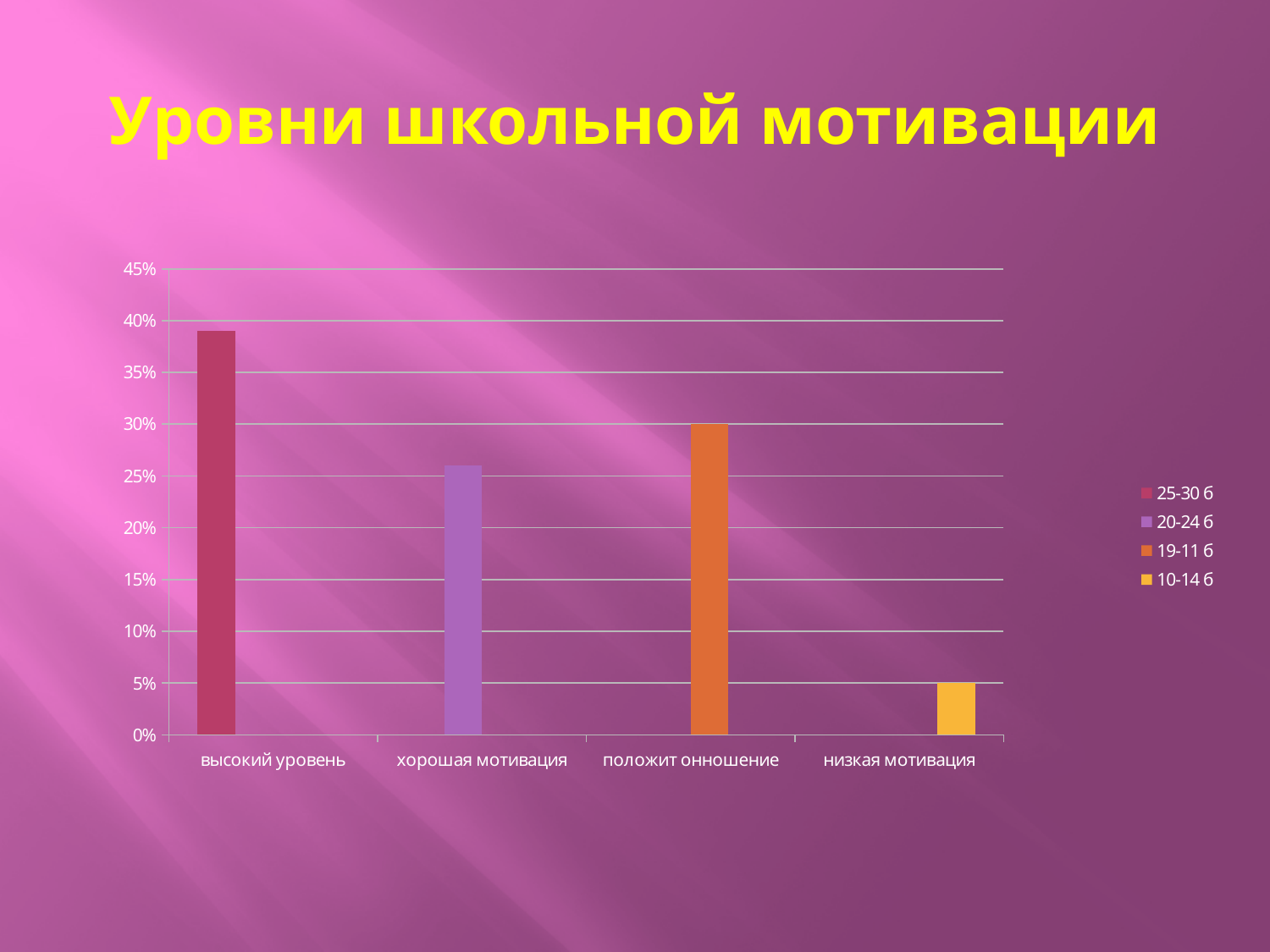
Which category has the lowest value? низкая мотивация Is the value for высокий уровень greater or less than 35%? greater What kind of chart is shown on the slide? bar chart What is the difference between the values for положит онношение and низкая мотивация? 25% Which is larger, the value for высокий уровень or the value for положит онношение? высокий уровень What is the value for низкая мотивация? 5% How many categories are shown on the x axis? 4 What is the title of the chart? Уровни школьной мотивации What is the value for положит онношение? 30% Which category has the highest value? высокий уровень How many series does the legend list? 4